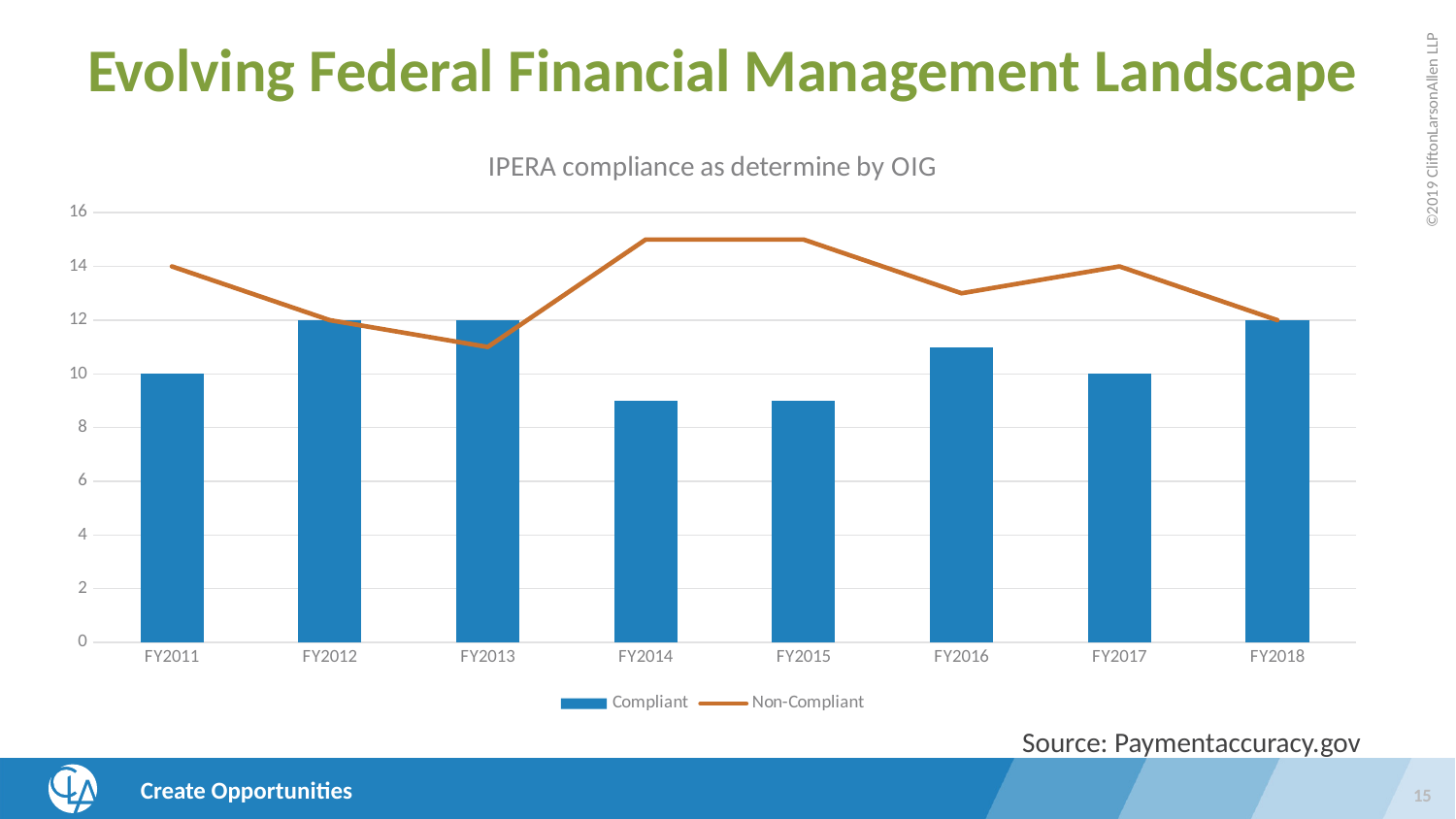
How many fiscal years are shown on the x axis? 8 What is the Compliant value for FY2011? 10 In which fiscal year is the Non-Compliant line at its lowest? FY2013 What is the title of the chart? IPERA compliance as determine by OIG How many series does the legend list? 2 Is the Compliant value for FY2014 greater or less than 10? less What is the Non-Compliant value for FY2017? 14 Is the Non-Compliant value for FY2015 greater or less than 14? greater What is the Compliant value for FY2018? 12 For FY2011, which is larger: the Compliant value or the Non-Compliant value? Non-Compliant What is the Non-Compliant value for FY2011? 14 What is the difference between the Non-Compliant and Compliant values for FY2011? 4